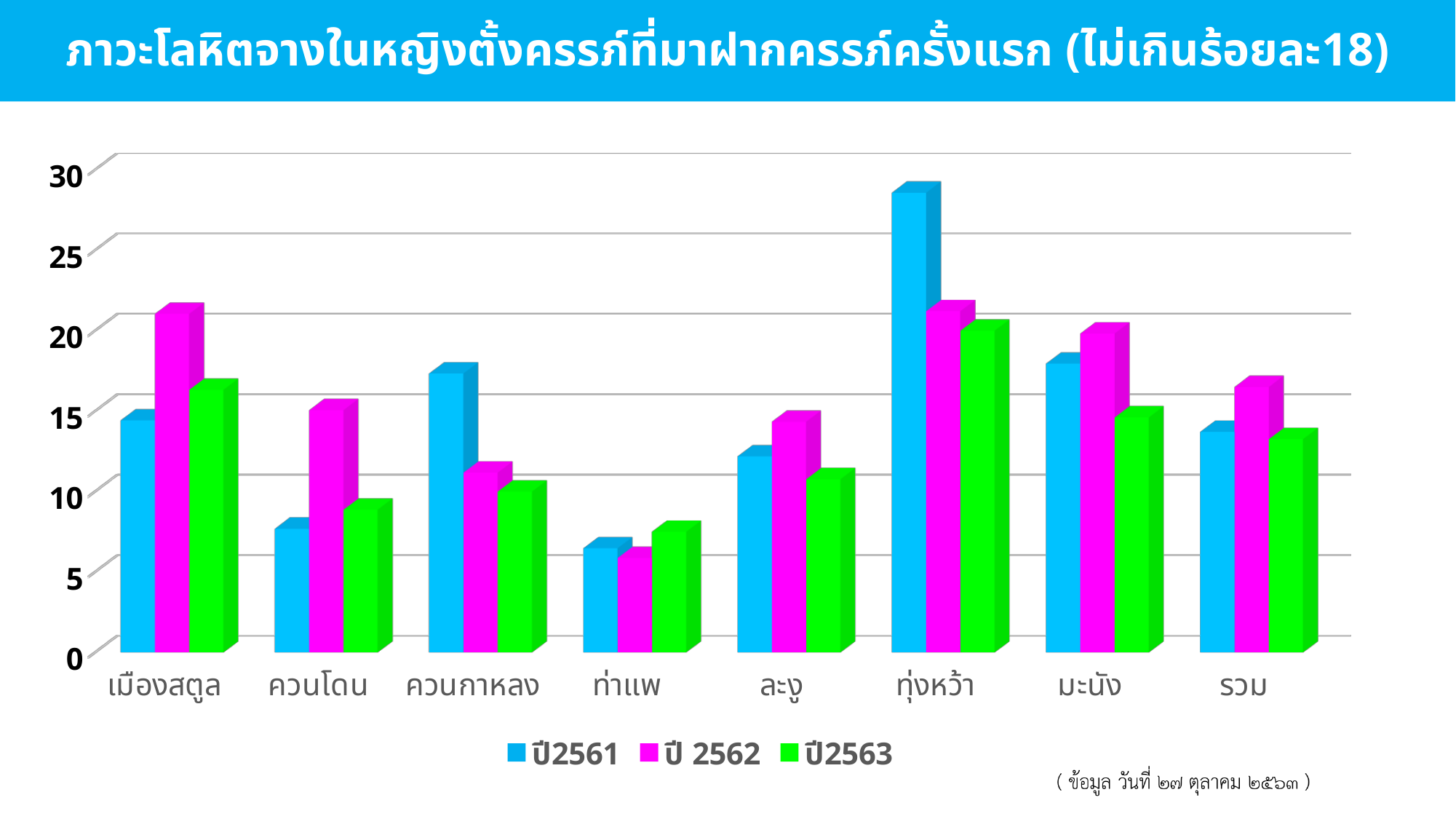
Which category has the lowest value for ปี2561? ท่าแพ Is the value for ควนโดน in ปี2561 greater or less than 10? less How many categories are shown along the x axis? 8 Is the value for ทุ่งหว้า in ปี2563 greater or less than 15? greater Is the value for ทุ่งหว้า in ปี2561 greater or less than 25? greater How many series does the legend list? 3 What colour represents the ปี2563 series in the legend? green For ควนกาหลง, which series has the larger value, ปี2561 or ปี 2562? ปี2561 What kind of chart is shown on the slide? bar chart For เมืองสตูล, which series has the larger value, ปี2561 or ปี 2562? ปี 2562 Which category has the highest value for ปี2561? ทุ่งหว้า Which category has the lowest value for ปี 2562? ท่าแพ